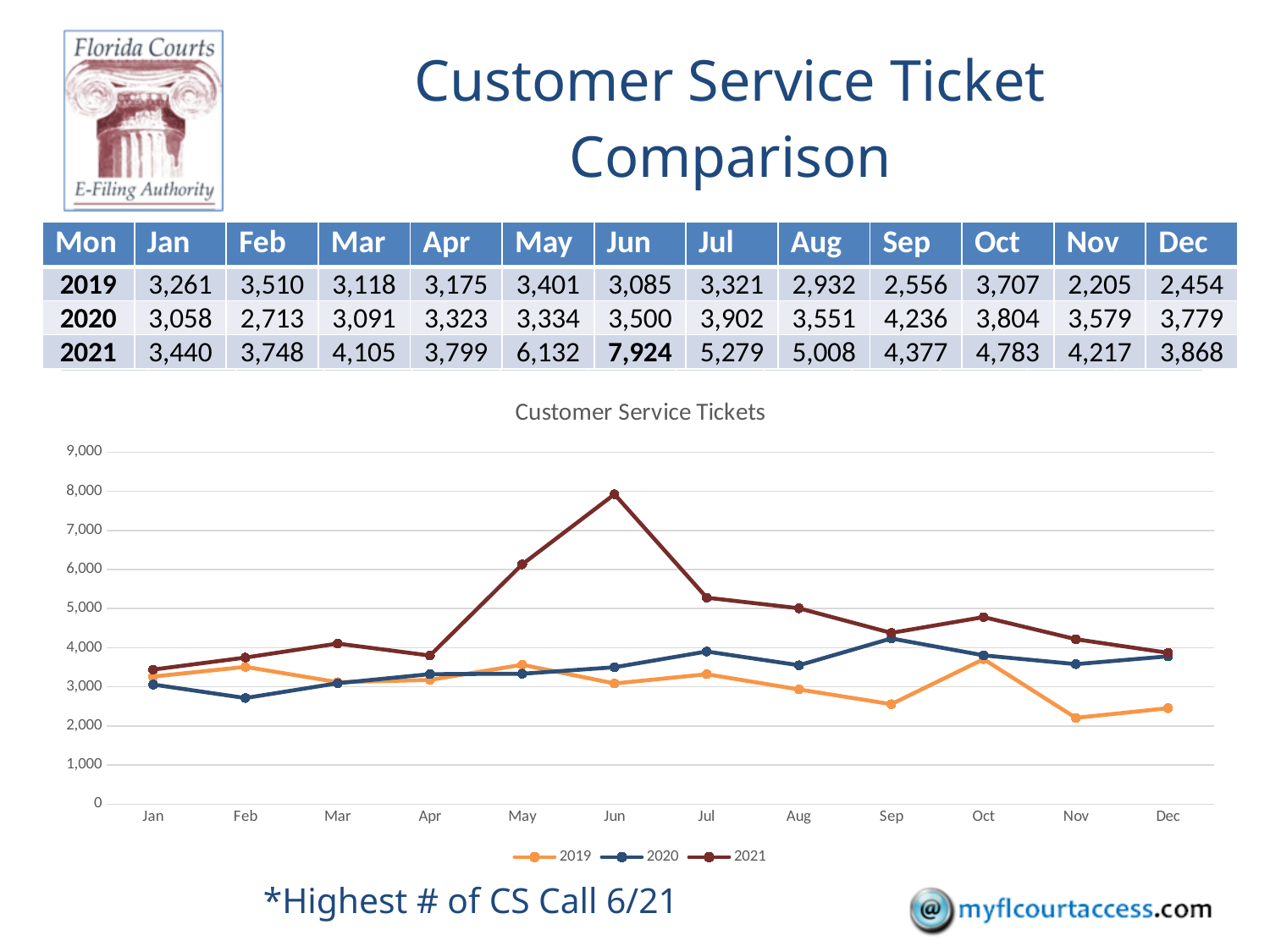
What is the value for 2020 in Sep? 4,236 What type of chart is shown on the slide? line chart What is the value for 2019 in Nov? 2,205 In which month is the 2019 series lowest? Nov What is the difference between the 2021 and 2020 values in May? 2,798 In which month is the 2021 series highest? Jun What is the value for 2021 in Jun? 7,924 Is the value for 2021 in Jul greater or less than 5,000? greater Which is larger in Feb, the 2019 value or the 2020 value? 2019 What is the title of the chart? Customer Service Tickets How many months are plotted along the x axis? 12 How many series does the legend list? 3